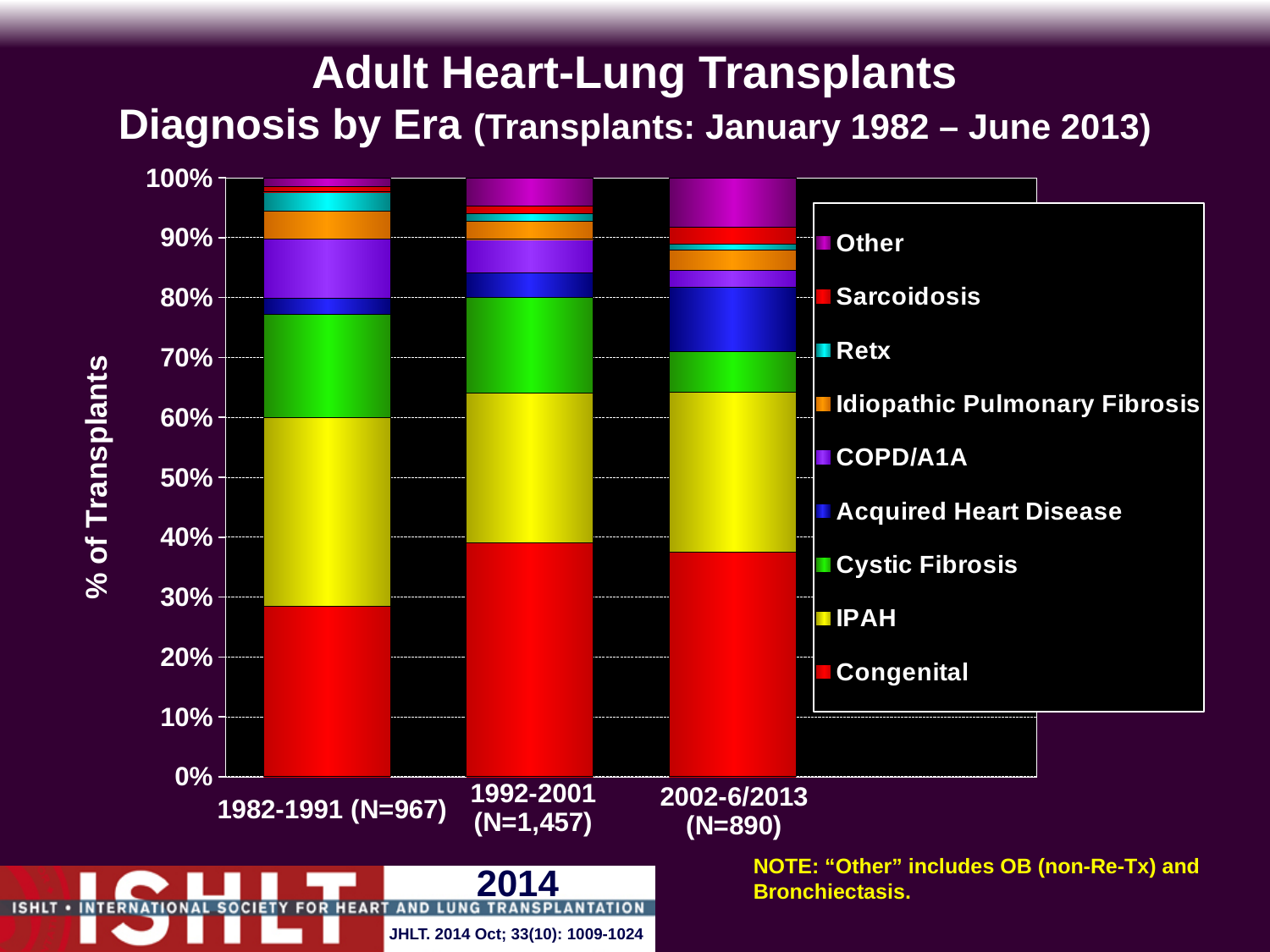
Is the Congenital share for 1982-1991 greater or less than 30%? less Which era has the larger Congenital share, 1982-1991 or 1992-2001? 1992-2001 Which diagnosis has the largest share in the 1992-2001 era? Congenital Does the share of the Other category rise or fall across the eras from 1982-1991 to 2002-6/2013? rise Is the Congenital share for 2002-6/2013 greater or less than 40%? less Which era has the larger Acquired Heart Disease share, 1982-1991 or 2002-6/2013? 2002-6/2013 What kind of chart is shown on the slide? Stacked bar chart Is the Congenital share for 1992-2001 greater or less than 30%? greater How many diagnosis series does the legend list? 9 How many era categories are shown on the x axis? 3 Which era has the larger Cystic Fibrosis share, 1982-1991 or 2002-6/2013? 1982-1991 What is the N value shown for the 1992-2001 era? N=1,457